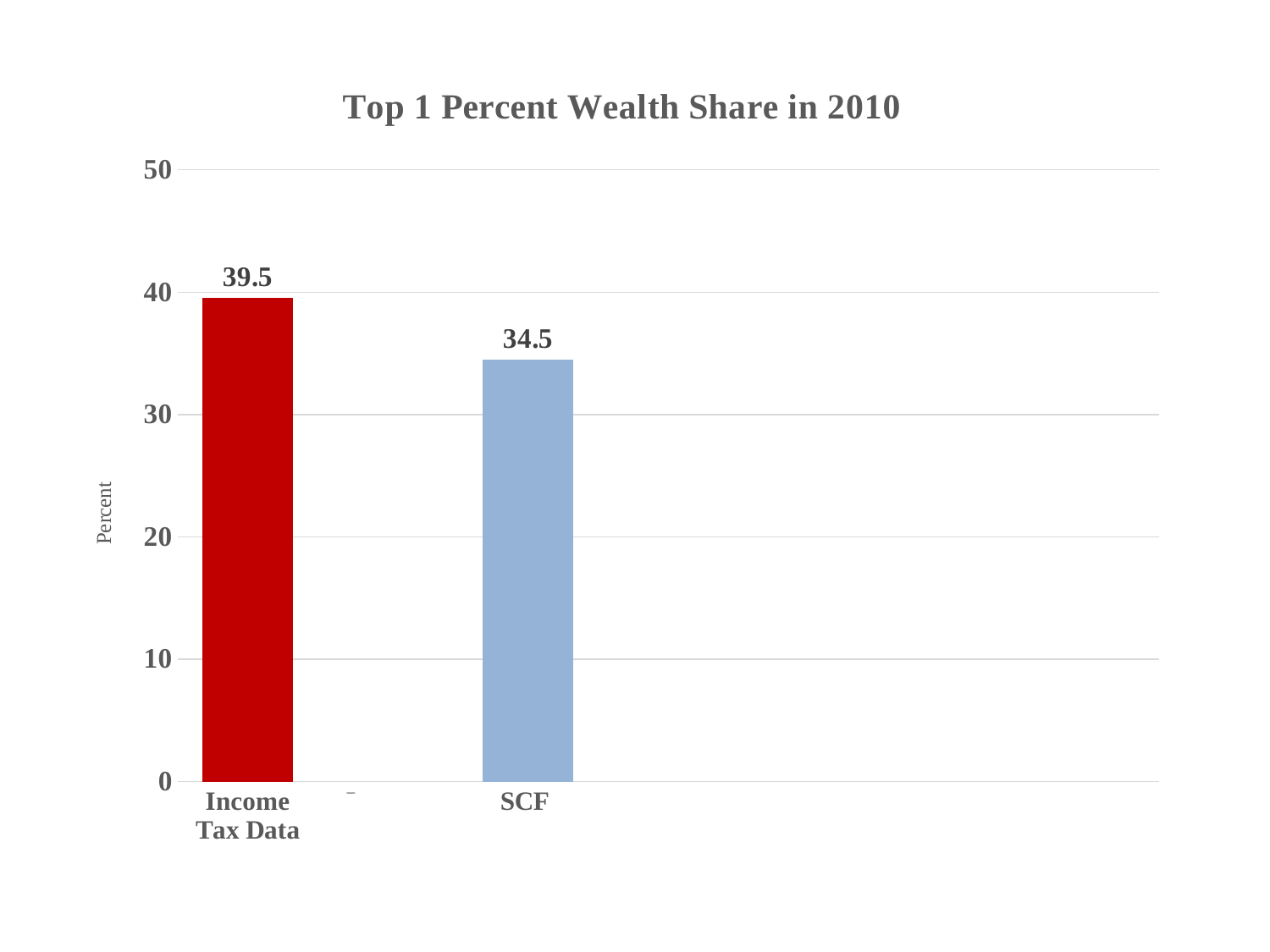
Which category has the lowest value? SCF What kind of chart is shown on the slide? bar chart What is the value for SCF? 34.5 Is the value for SCF greater or less than 30? greater Which is larger, the value for Income Tax Data or the value for SCF? Income Tax Data Is the value for Income Tax Data greater or less than 40? less How many bars are plotted in the chart? 2 What is the difference between the values for Income Tax Data and SCF? 5.0 Which category has the highest value? Income Tax Data What is the label of the vertical axis? Percent What is the value for Income Tax Data? 39.5 What is the title of the chart? Top 1 Percent Wealth Share in 2010